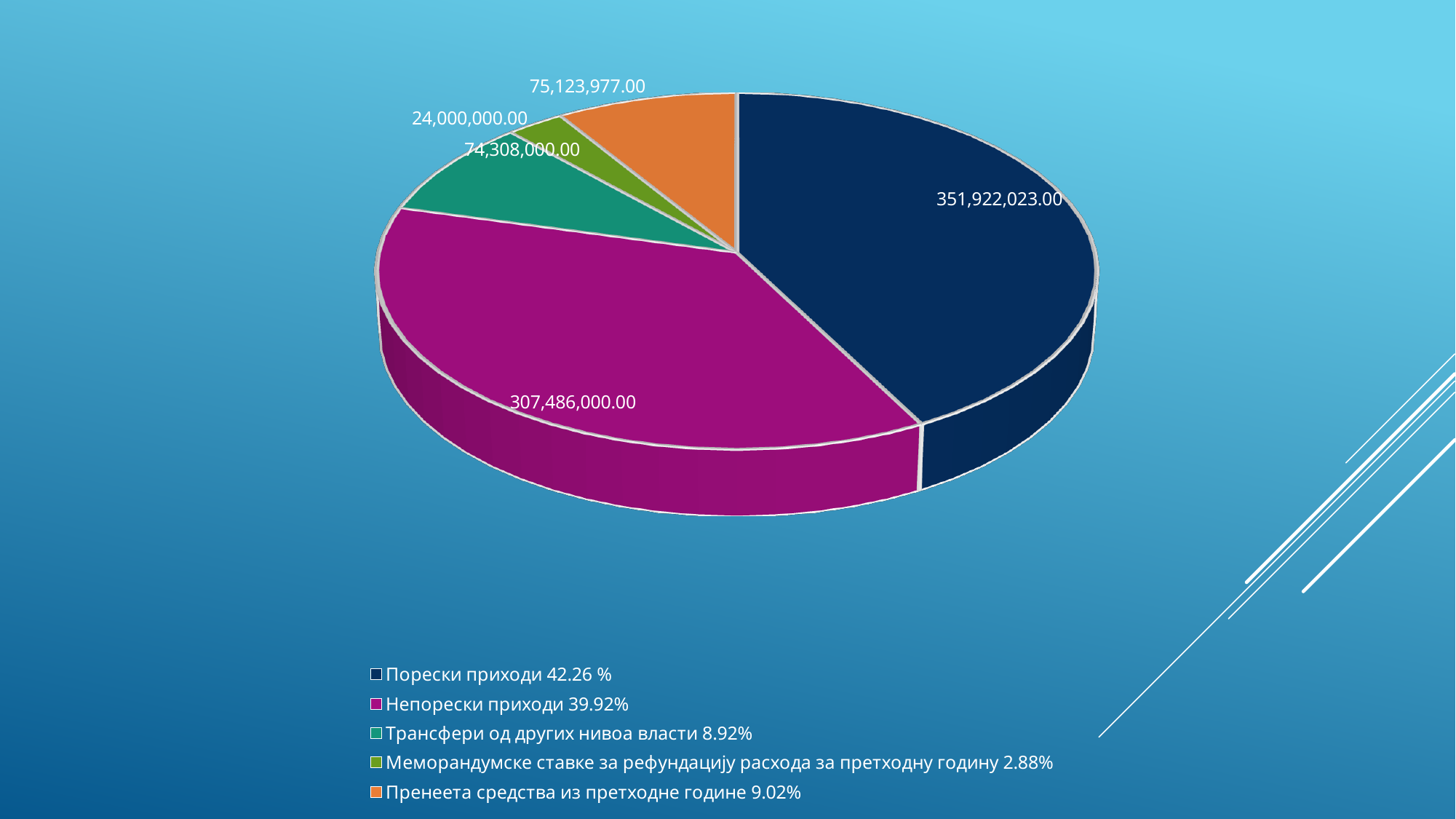
Which category has the smallest slice of the pie? Меморандумске ставке за рефундацију расхода за претходну годину What is the value of the Трансфери од других нивоа власти slice? 74,308,000.00 How many slices does the pie chart have? 5 What share of the pie does Трансфери од других нивоа власти represent, according to the legend? 8.92% What colour is the Пренеета средства из претходне године slice? Orange What is the value of the Порески приходи slice? 351,922,023.00 What is the value of the Непорески приходи slice? 307,486,000.00 Which category has the largest slice of the pie? Порески приходи What is the value of the Пренеета средства из претходне године slice? 75,123,977.00 What is the difference between the Порески приходи value and the Непорески приходи value? 44,436,023.00 Which is larger, the Порески приходи slice or the Непорески приходи slice? Порески приходи What type of chart is shown on the slide? Pie chart